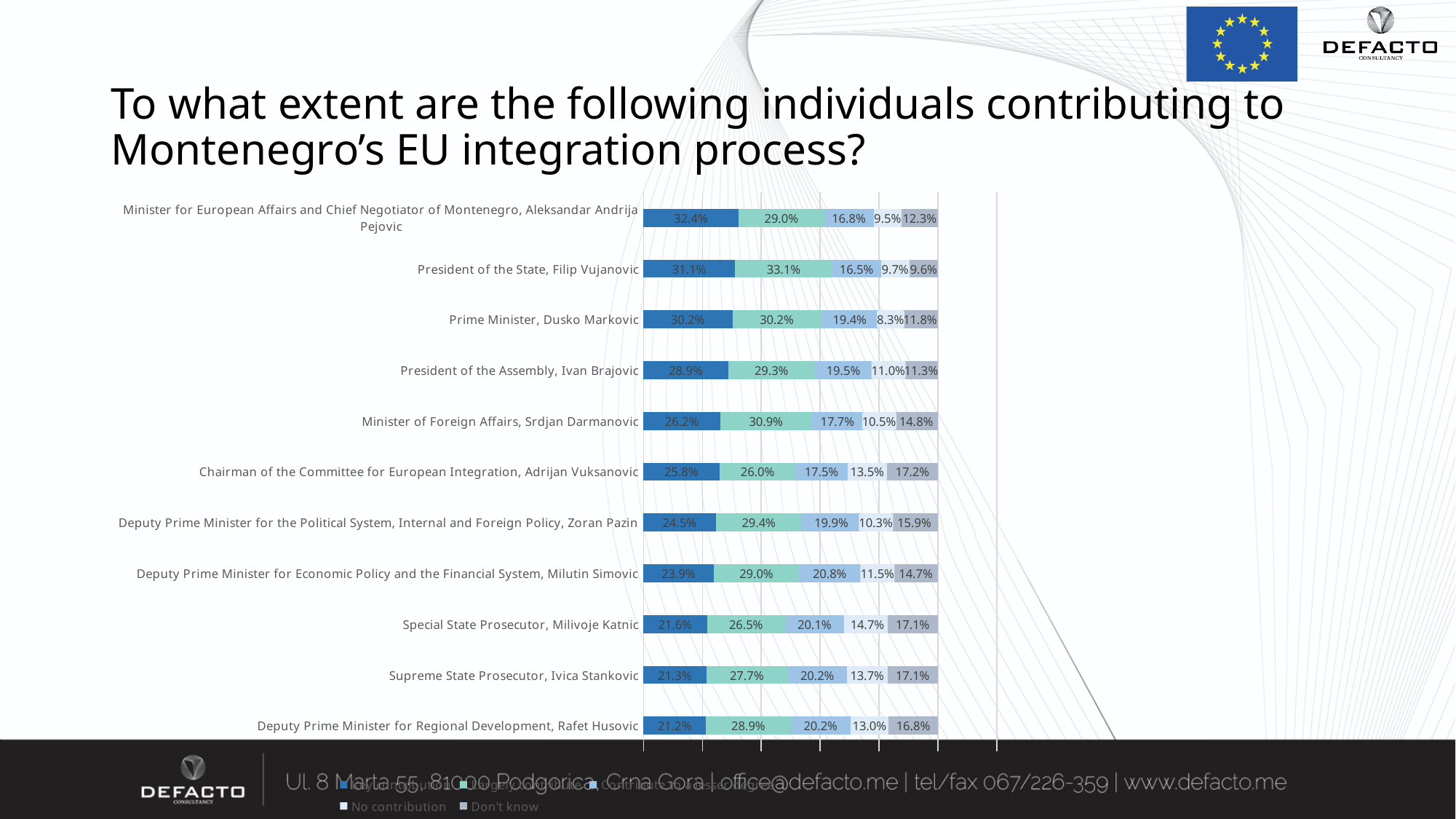
How many individuals (categories) are listed in the chart? 11 What is the value of the leftmost (dark blue) segment for Prime Minister, Dusko Markovic? 30.2% What is the 'Don't know' value for Chairman of the Committee for European Integration, Adrijan Vuksanovic? 17.2% Which individual has the largest leftmost (dark blue) segment? Minister for European Affairs and Chief Negotiator of Montenegro, Aleksandar Andrija Pejovic What is the difference between the 'No contribution' values for Milivoje Katnic and Aleksandar Andrija Pejovic? 5.2 percentage points Which has a larger 'Don't know' value: Zoran Pazin or Dusko Markovic? Zoran Pazin What is the 'No contribution' value for President of the Assembly, Ivan Brajovic? 11.0% What is the 'Don't know' value for Deputy Prime Minister for Regional Development, Rafet Husovic? 16.8% What type of chart is shown on the slide? Stacked bar chart What is the title of the chart on the slide? To what extent are the following individuals contributing to Montenegro's EU integration process? Which individual has the lowest 'Don't know' value? President of the State, Filip Vujanovic What is the 'No contribution' value for Special State Prosecutor, Milivoje Katnic? 14.7%